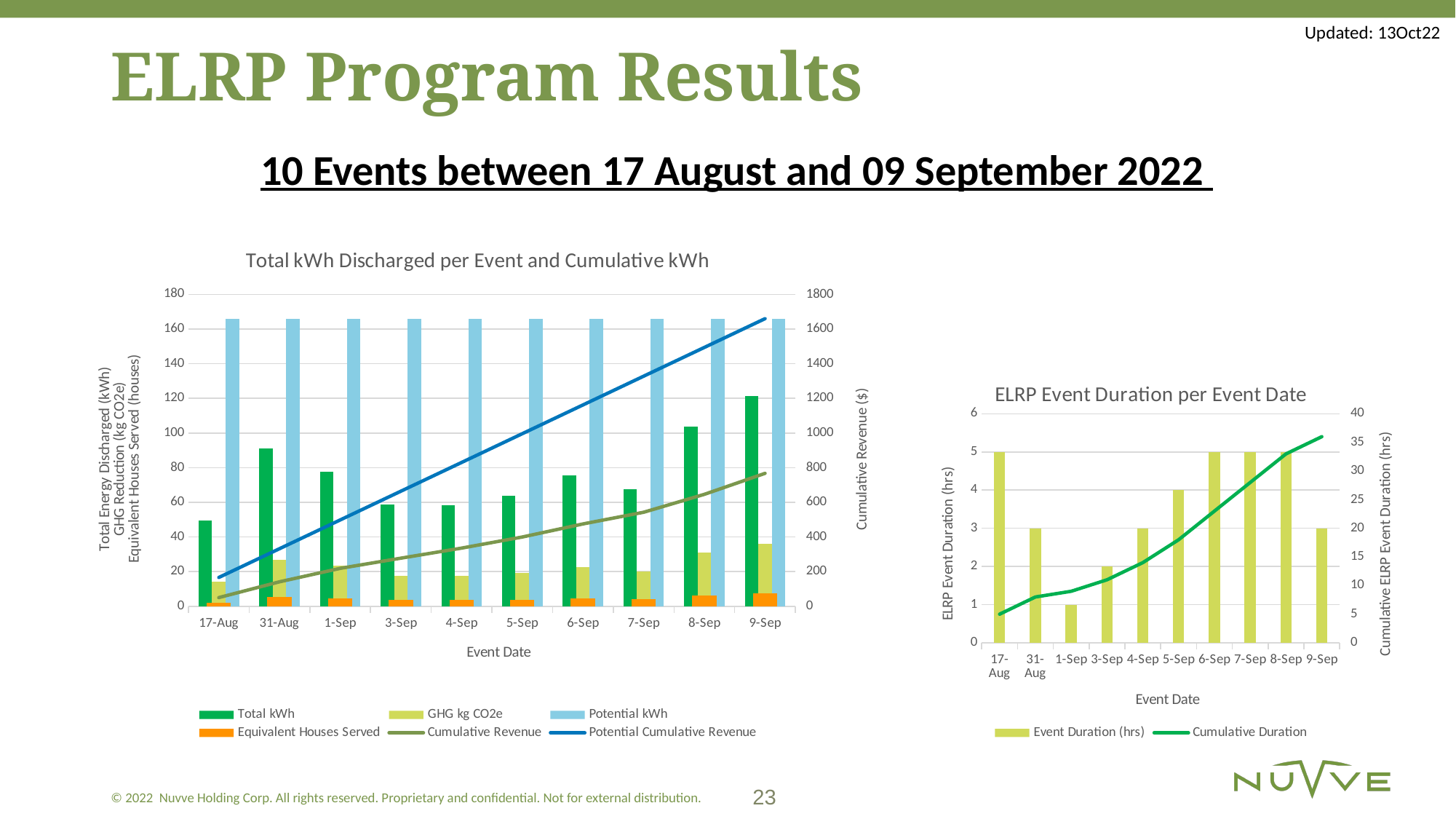
On the chart titled 'Total kWh Discharged per Event and Cumulative kWh', how many event dates are shown on the x axis? 10 On the chart titled 'Total kWh Discharged per Event and Cumulative kWh', which event date has the lowest Total kWh? 17-Aug On the chart titled 'ELRP Event Duration per Event Date', which event date has the lowest Event Duration (hrs)? 1-Sep On the chart titled 'Total kWh Discharged per Event and Cumulative kWh', is the Total kWh for 9-Sep greater or less than 100? greater On the chart titled 'Total kWh Discharged per Event and Cumulative kWh', how many series does the legend list? 6 On the chart titled 'Total kWh Discharged per Event and Cumulative kWh', which has the larger Total kWh, 31-Aug or 1-Sep? 31-Aug On the chart titled 'ELRP Event Duration per Event Date', what is the difference in Event Duration (hrs) between 17-Aug and 1-Sep? 4 On the chart titled 'ELRP Event Duration per Event Date', how many series does the legend list? 2 On the chart titled 'ELRP Event Duration per Event Date', does the Cumulative Duration line rise or fall from 17-Aug to 9-Sep? rise On the chart titled 'ELRP Event Duration per Event Date', what is the Event Duration (hrs) for 5-Sep? 4 On the chart titled 'Total kWh Discharged per Event and Cumulative kWh', which event date has the highest Total kWh? 9-Sep On the chart titled 'ELRP Event Duration per Event Date', what is the Event Duration (hrs) for 1-Sep? 1